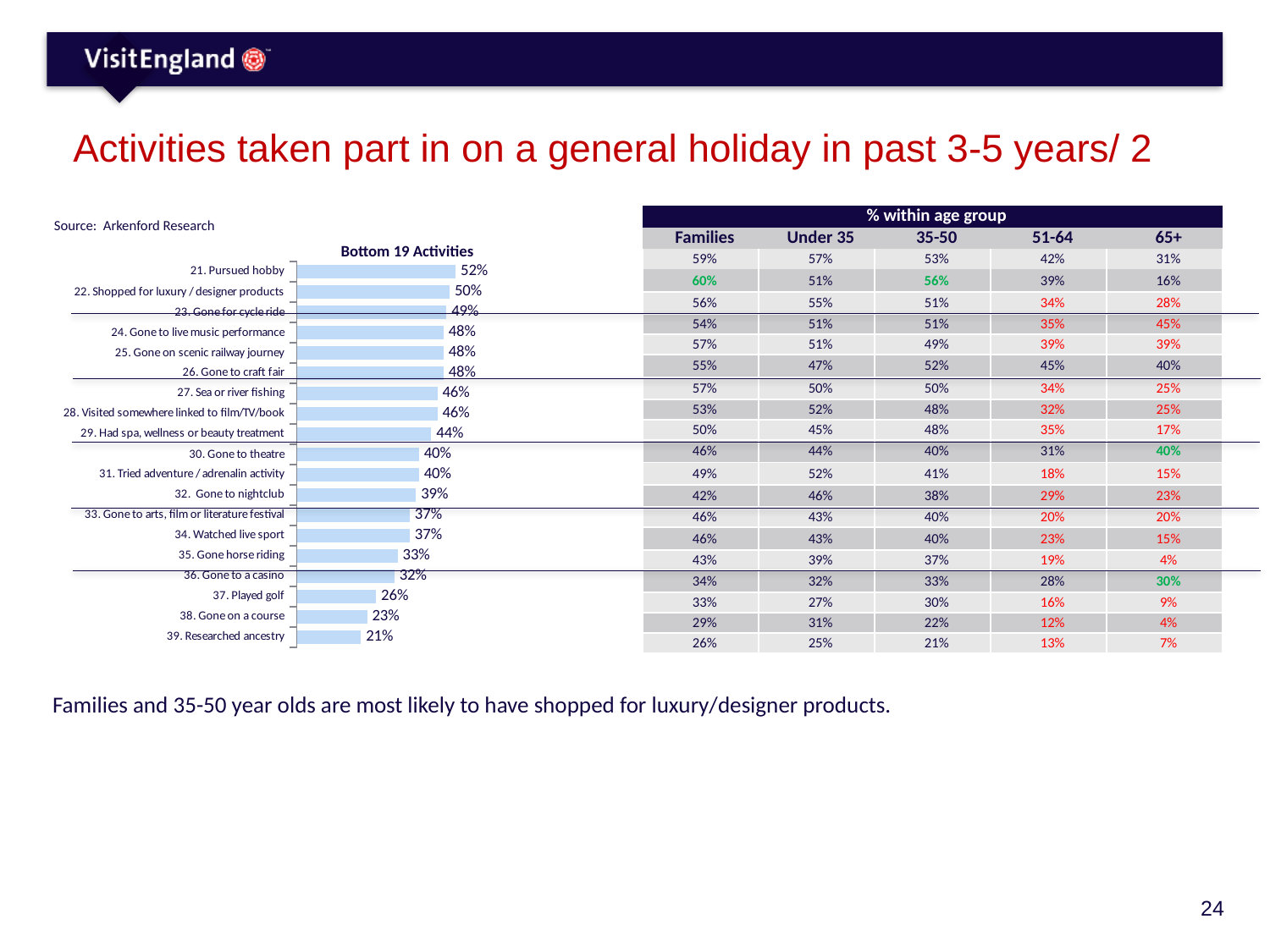
What is the value for "Pursued hobby" in the Bottom 19 Activities chart? 52% Which activity has the highest value in the Bottom 19 Activities chart? 21. Pursued hobby In the Bottom 19 Activities chart, which is larger: the value for "Gone to nightclub" or the value for "Watched live sport"? Gone to nightclub What is the value for "Gone horse riding" in the Bottom 19 Activities chart? 33% What is the difference between the values for "Gone to a casino" and "Played golf" in the Bottom 19 Activities chart? 6% How many activities are shown in the Bottom 19 Activities chart? 19 What is the difference between the values for "Pursued hobby" and "Researched ancestry" in the Bottom 19 Activities chart? 31% In the Bottom 19 Activities chart, which is larger: the value for "Gone on a course" or the value for "Gone to theatre"? Gone to theatre What kind of chart is the Bottom 19 Activities chart? Bar chart What is the title of the bar chart on the slide? Bottom 19 Activities What is the value for "Had spa, wellness or beauty treatment" in the Bottom 19 Activities chart? 44% Which activity has the lowest value in the Bottom 19 Activities chart? 39. Researched ancestry